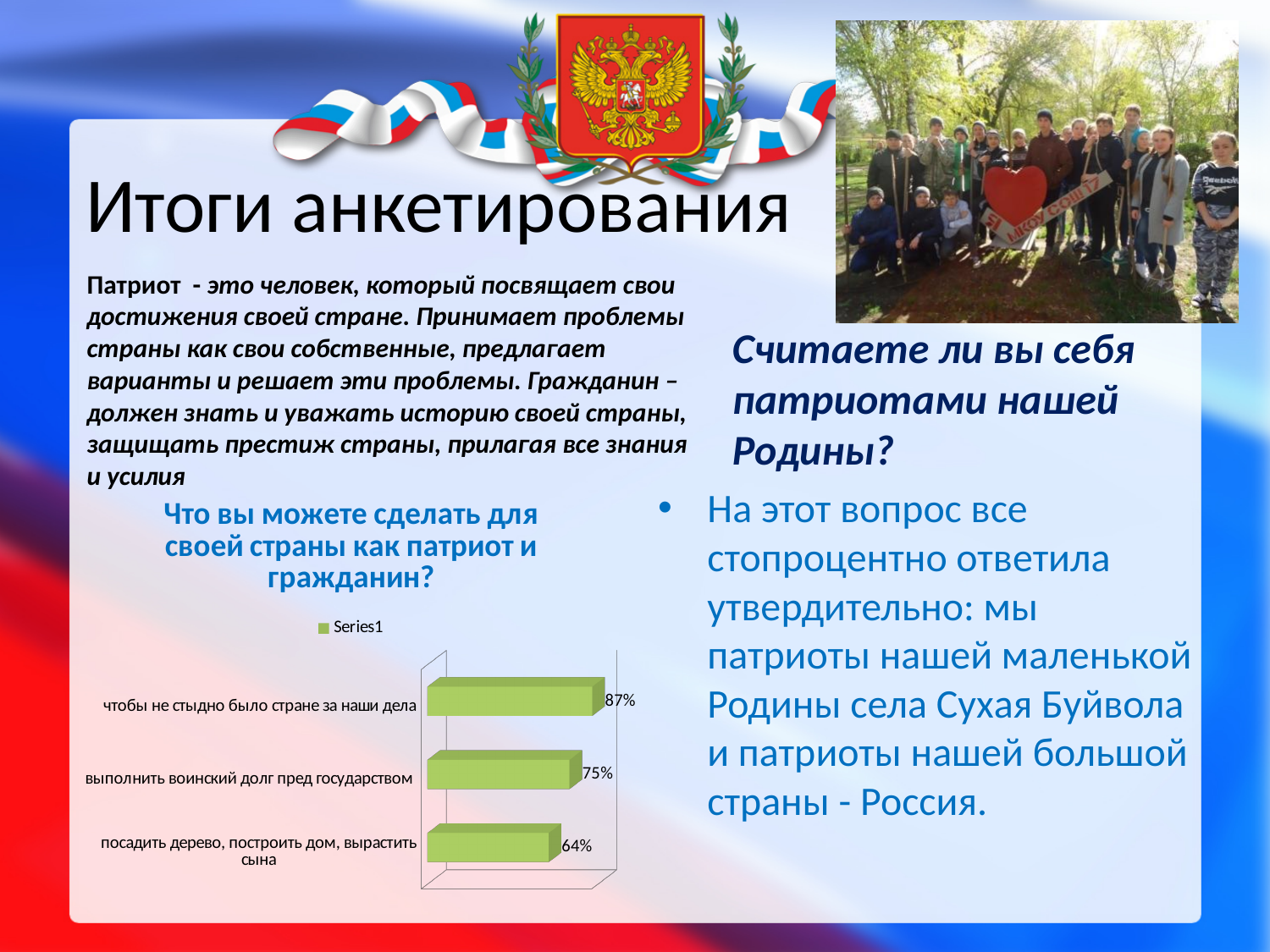
How many categories does the chart show? 3 Which is larger: the value for "выполнить воинский долг пред государством" or for "посадить дерево, построить дом, вырастить сына"? выполнить воинский долг пред государством Which category has the lowest value? посадить дерево, построить дом, вырастить сына Which category has the highest value? чтобы не стыдно было стране за наши дела What value is shown for "чтобы не стыдно было стране за наши дела"? 87% What value is shown for "выполнить воинский долг пред государством"? 75% What kind of chart is shown on the slide? bar chart How many series does the legend list? 1 What is the title of the chart? Что вы можете сделать для своей страны как патриот и гражданин? What is the difference between the values for "чтобы не стыдно было стране за наши дела" and "посадить дерево, построить дом, вырастить сына"? 23% What is the difference between the values for "выполнить воинский долг пред государством" and "посадить дерево, построить дом, вырастить сына"? 11% What value is shown for "посадить дерево, построить дом, вырастить сына"? 64%